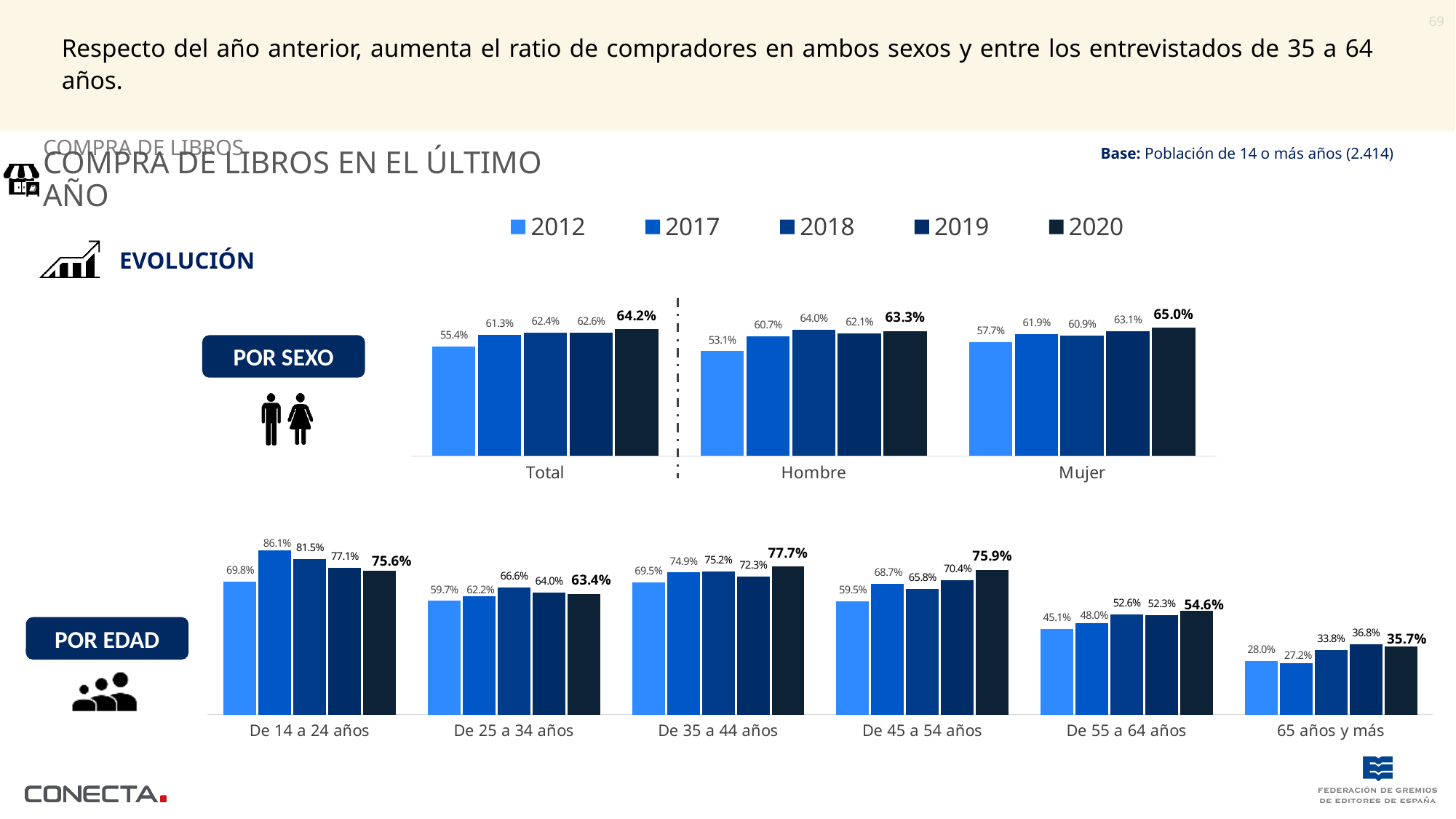
How many age groups are shown on the x axis of the POR EDAD chart? 6 In the POR EDAD chart, which age group has the highest value in 2020? De 35 a 44 años In the POR EDAD chart, do the 2020 values rise or fall from De 35 a 44 años to 65 años y más? Fall In the POR EDAD chart, which is larger for De 14 a 24 años: the 2017 value or the 2020 value? 2017 What kind of chart is the POR SEXO chart? Bar chart In the POR EDAD chart, what is the value for De 55 a 64 años in 2019? 52.3% How many series does the legend list? 5 In the POR EDAD chart, which age group has the lowest value in 2012? 65 años y más In the POR SEXO chart, what is the value for Hombre in 2012? 53.1% In the POR EDAD chart, what is the difference between the 2020 and 2019 values for De 45 a 54 años? 5.5% In the POR SEXO chart, what is the difference between the 2020 and 2019 values for Total? 1.6% In the POR SEXO chart, what is the value for Mujer in 2020? 65.0%